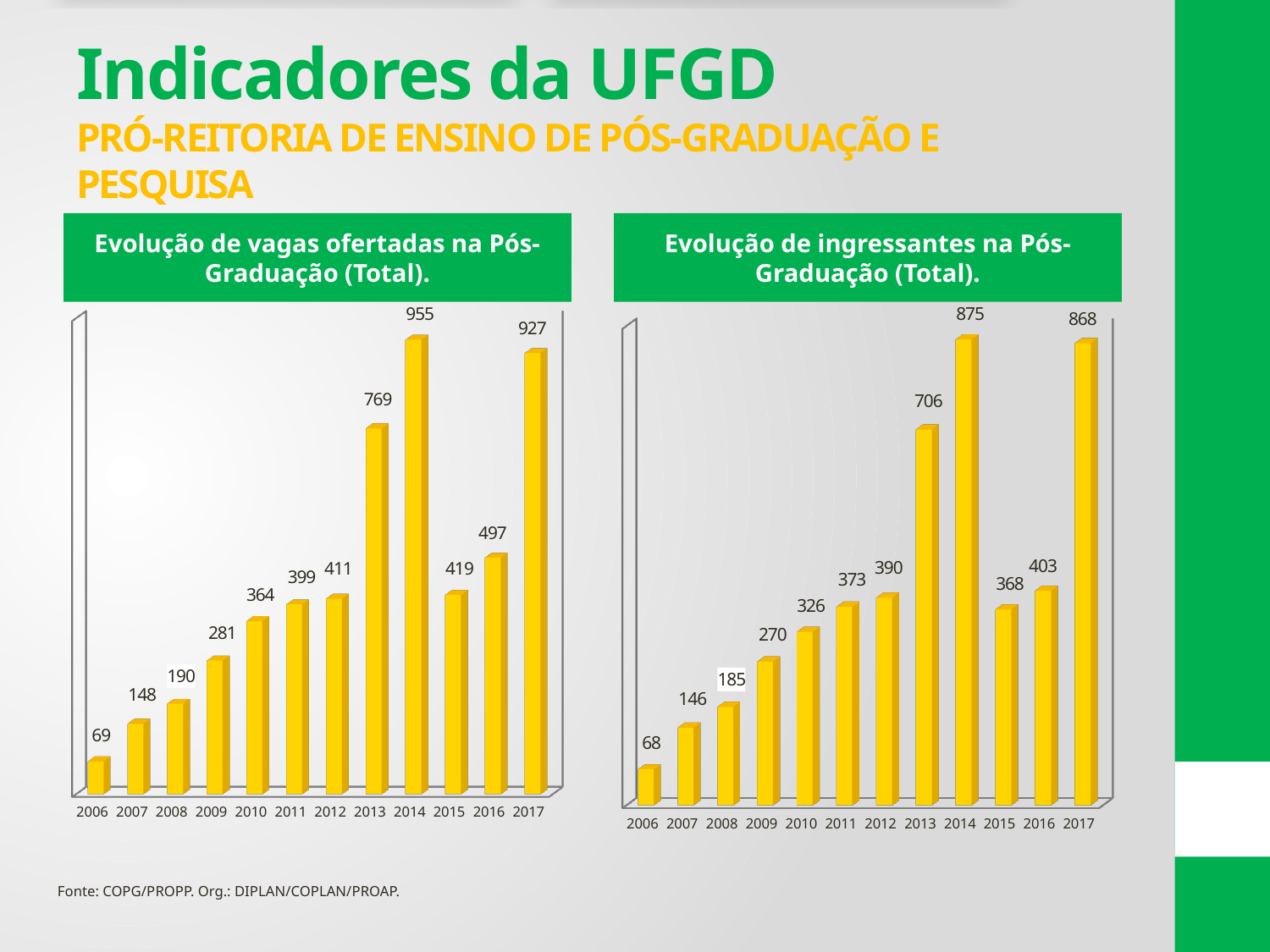
In the chart 'Evolução de ingressantes na Pós-Graduação (Total)', what is the difference between the values for 2014 and 2015? 507 In the chart 'Evolução de ingressantes na Pós-Graduação (Total)', what is the value for 2013? 706 In the chart 'Evolução de vagas ofertadas na Pós-Graduação (Total)', what is the value for 2014? 955 In the chart 'Evolução de ingressantes na Pós-Graduação (Total)', which is larger, the value for 2011 or the value for 2016? 2016 What is the title of the chart on the right side of the slide? Evolução de ingressantes na Pós-Graduação (Total). In the chart 'Evolução de vagas ofertadas na Pós-Graduação (Total)', which is larger, the value for 2013 or the value for 2015? 2013 In the chart 'Evolução de vagas ofertadas na Pós-Graduação (Total)', which year has the lowest value? 2006 In the chart 'Evolução de ingressantes na Pós-Graduação (Total)', which year has the highest value? 2014 How many years are shown on the x axis of the chart 'Evolução de vagas ofertadas na Pós-Graduação (Total)'? 12 What kind of chart is 'Evolução de ingressantes na Pós-Graduação (Total)'? Bar chart In the chart 'Evolução de vagas ofertadas na Pós-Graduação (Total)', what is the difference between the values for 2017 and 2016? 430 In the chart 'Evolução de vagas ofertadas na Pós-Graduação (Total)', do the values rise or fall from 2006 to 2014? Rise